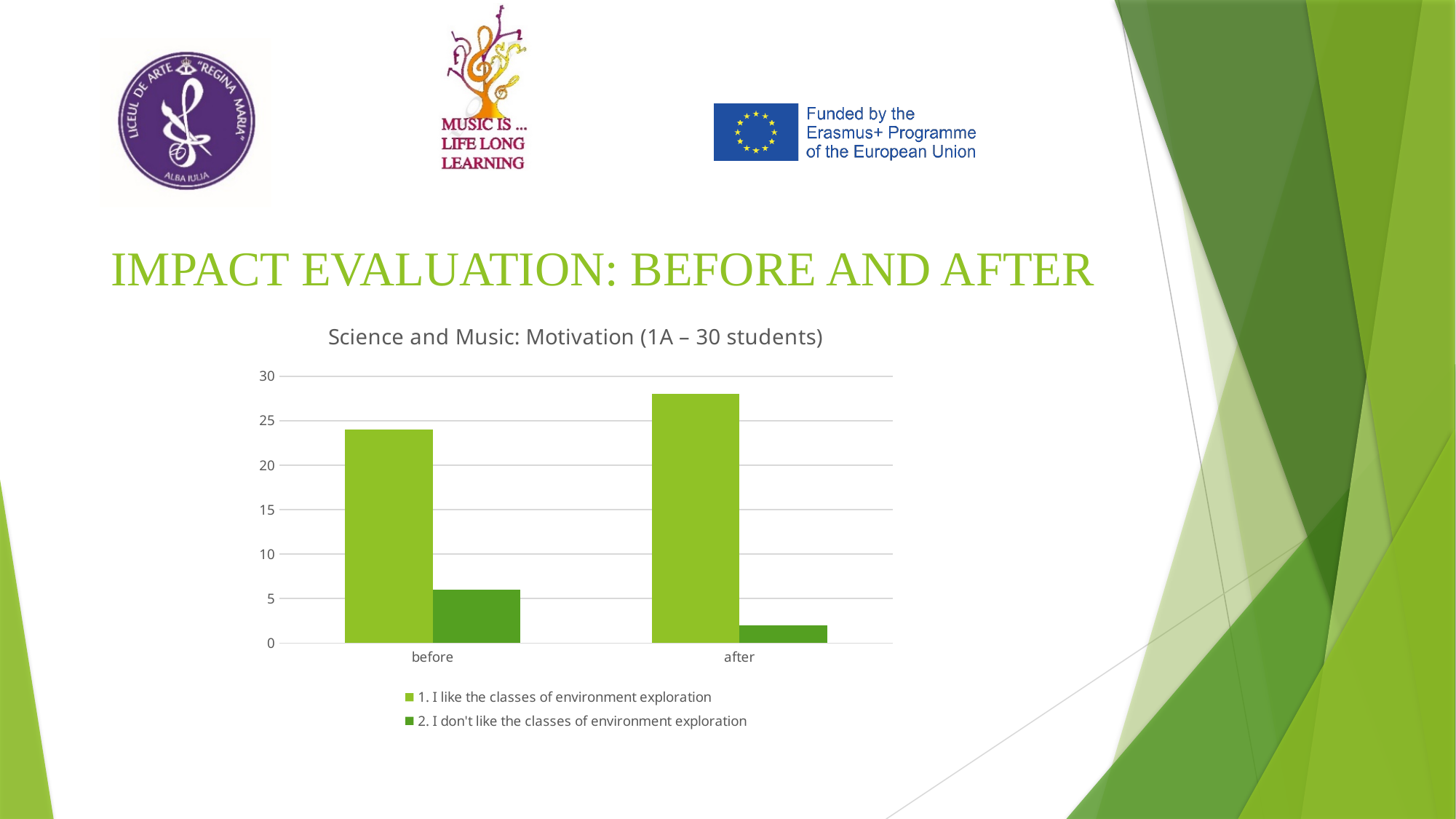
How many categories are shown on the x axis? 2 What type of chart is shown on the slide? bar chart Is the value for '2. I don't like the classes of environment exploration' in the 'after' category greater or less than 5? less Which category has the higher value for '1. I like the classes of environment exploration', 'before' or 'after'? after How many series does the legend list? 2 Is the value for '1. I like the classes of environment exploration' in the 'before' category greater or less than 20? greater Which series is shown in the darker green colour? 2. I don't like the classes of environment exploration Is the value for '2. I don't like the classes of environment exploration' in the 'before' category greater or less than 10? less Which category has the lower value for '2. I don't like the classes of environment exploration', 'before' or 'after'? after What is the title of the chart? Science and Music: Motivation (1A – 30 students) Does the value for '2. I don't like the classes of environment exploration' rise or fall from 'before' to 'after'? fall